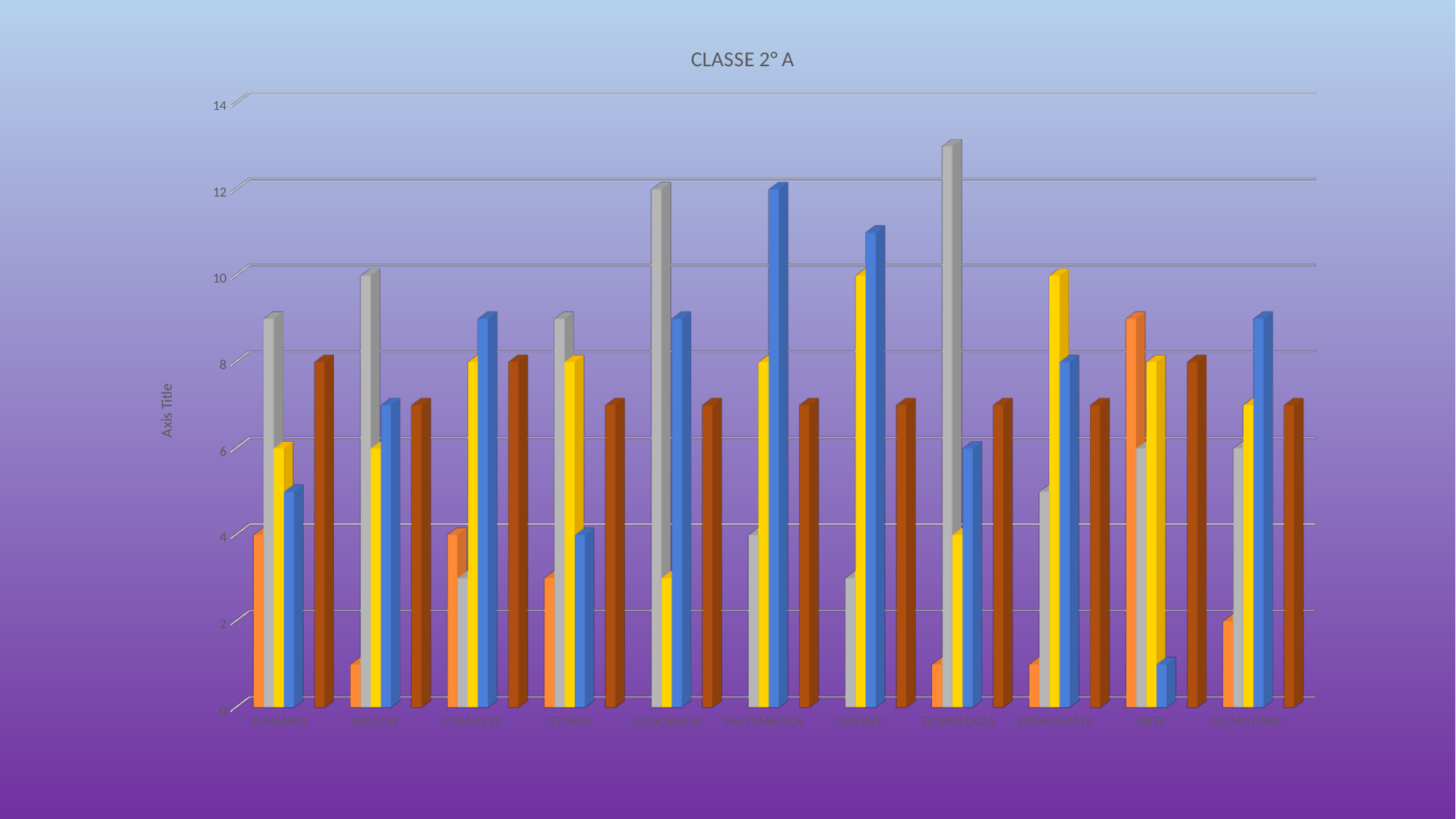
Is the blue bar for MATEMATICA greater or less than 10? greater Which is larger, the gray bar for GEOGRAFIA or the gray bar for INGLESE? GEOGRAFIA Which category has the lowest blue bar? ARTE What is the label on the vertical axis of the chart? Axis Title What kind of chart is shown on the slide? bar chart What is the title of the chart? CLASSE 2° A How many categories are shown along the x axis of the chart? 11 Is the gray bar for TECNOLOGIA greater or less than 12? greater Is the yellow bar for ED.MUSICALE greater or less than 8? greater Which category has the tallest gray bar? TECNOLOGIA